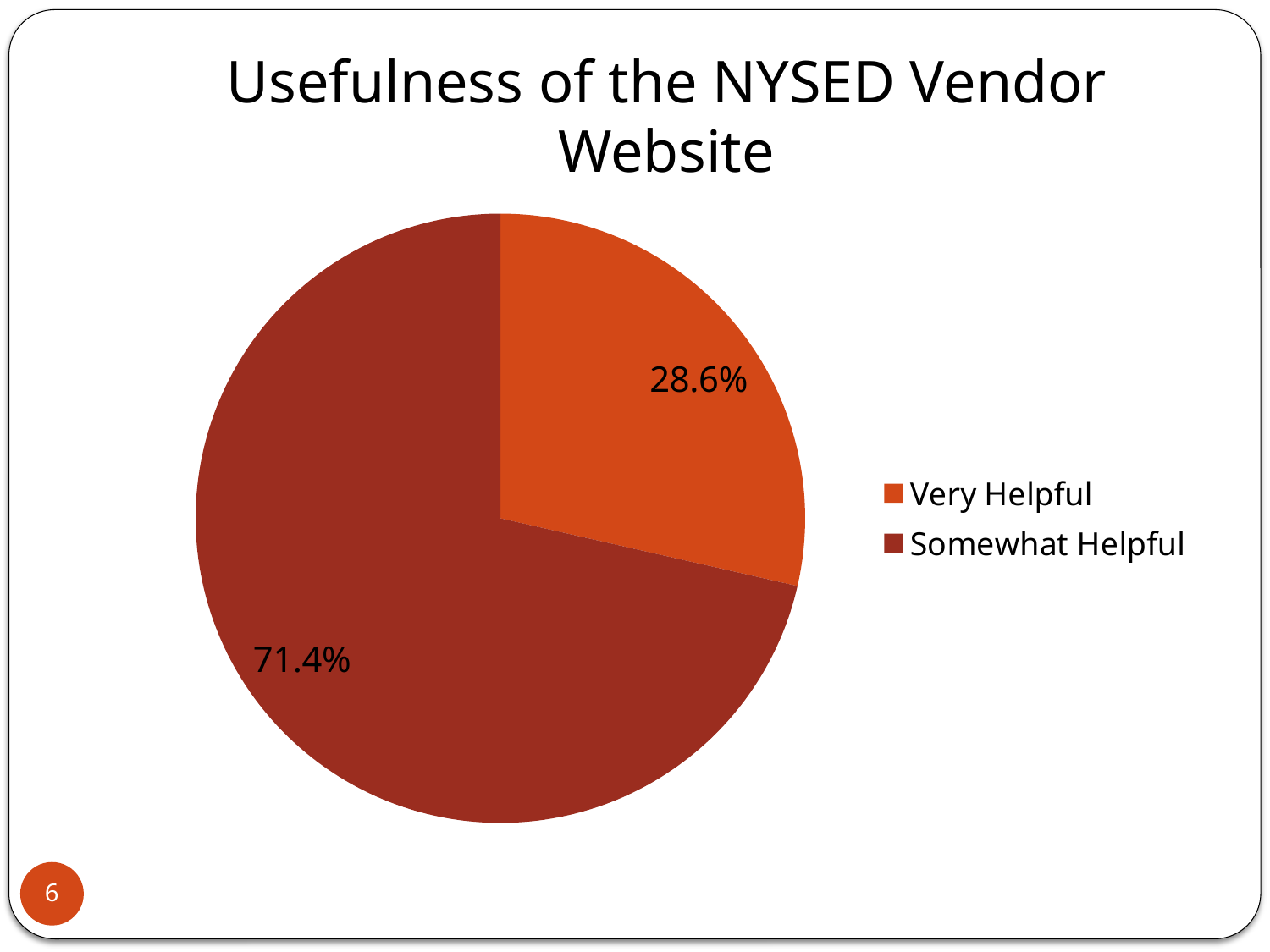
How many entries does the legend list? 2 Which legend entry is shown in the lighter orange colour? Very Helpful What kind of chart is shown on the slide? pie chart What share of the pie is labelled Somewhat Helpful? 71.4% What is the difference in percentage points between the Somewhat Helpful and Very Helpful slices? 42.8 Which category has the largest slice of the pie? Somewhat Helpful Is the share for Somewhat Helpful greater or less than 50%? greater What share of the pie is labelled Very Helpful? 28.6% Which slice is larger, Very Helpful or Somewhat Helpful? Somewhat Helpful Which category has the smallest slice of the pie? Very Helpful How many categories does the pie chart show? 2 What is the title of the slide? Usefulness of the NYSED Vendor Website